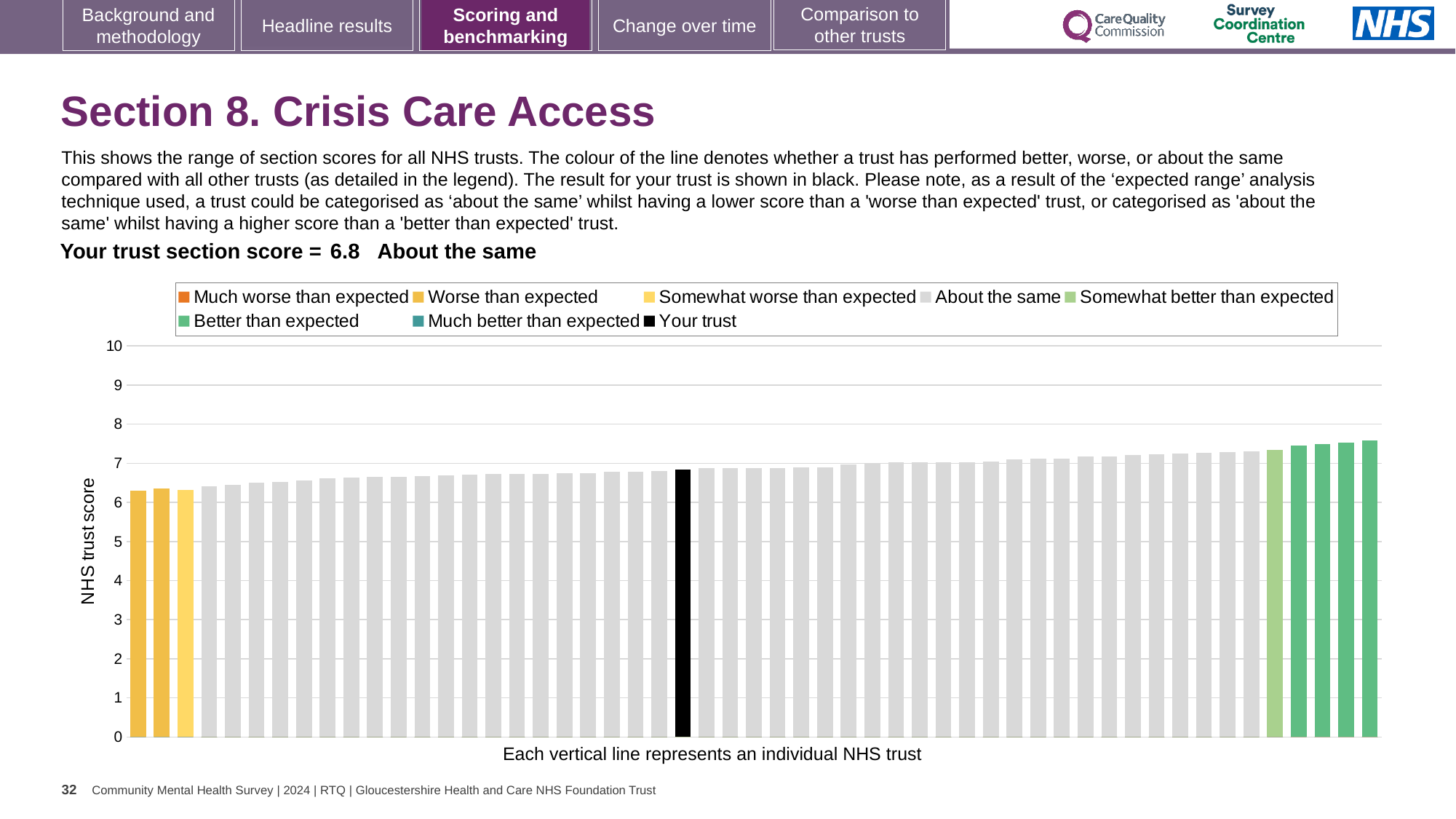
What kind of chart is shown on the slide? bar chart Is the value of the leftmost bar greater or less than 7? less How many entries does the chart legend list? 8 Is the value of the rightmost bar greater or less than 7? greater Which performance category is your trust placed in for Section 8? About the same What colour is the bar representing your trust? black What is the section score for your trust shown on the slide? 6.8 Which is higher, the leftmost bar or the rightmost bar? the rightmost bar How many bars are coloured as 'Better than expected'? 4 Do the bar values rise or fall from left to right along the x axis? rise Is the value of the highest bar greater or less than 8? less How many bars are coloured as 'Worse than expected'? 2